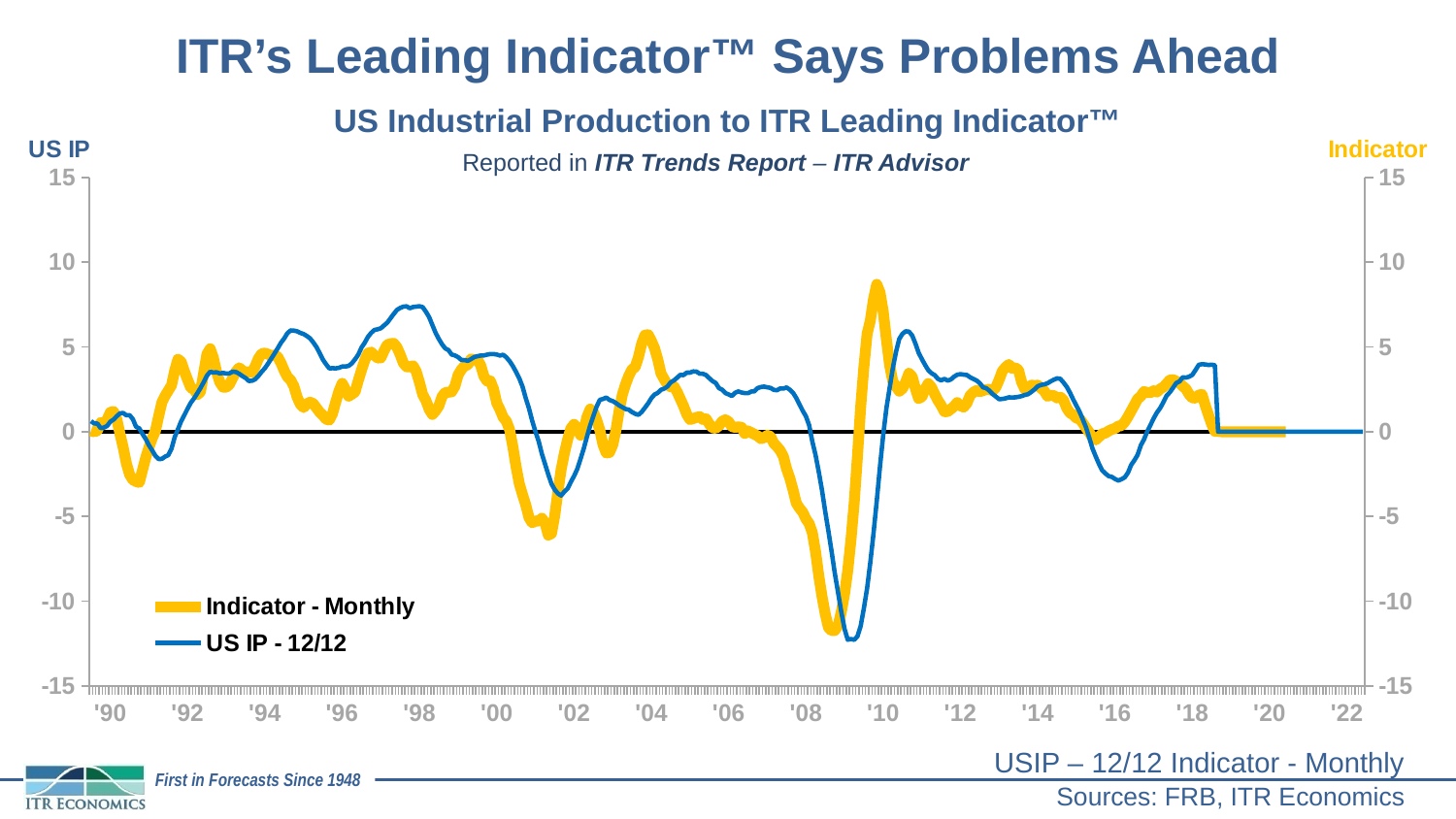
What is the title of the chart? US Industrial Production to ITR Leading Indicator™ Is the value of US IP - 12/12 at its peak around 1998 greater or less than 5? greater Does the Indicator - Monthly line rise or fall between '16 and '18? Rise What is the highest value shown on the left vertical axis? 15 Around 2010, which series reaches a higher peak, Indicator - Monthly or US IP - 12/12? Indicator - Monthly Is the value of Indicator - Monthly at its low point around 2001 greater or less than -5? less How many series does the legend list? 2 Is the peak value of Indicator - Monthly around 2010 greater or less than 5? greater Which series is drawn in yellow according to the legend? Indicator - Monthly Does the US IP - 12/12 line rise or fall between '08 and '09? Fall What kind of chart is shown on the slide? Line chart